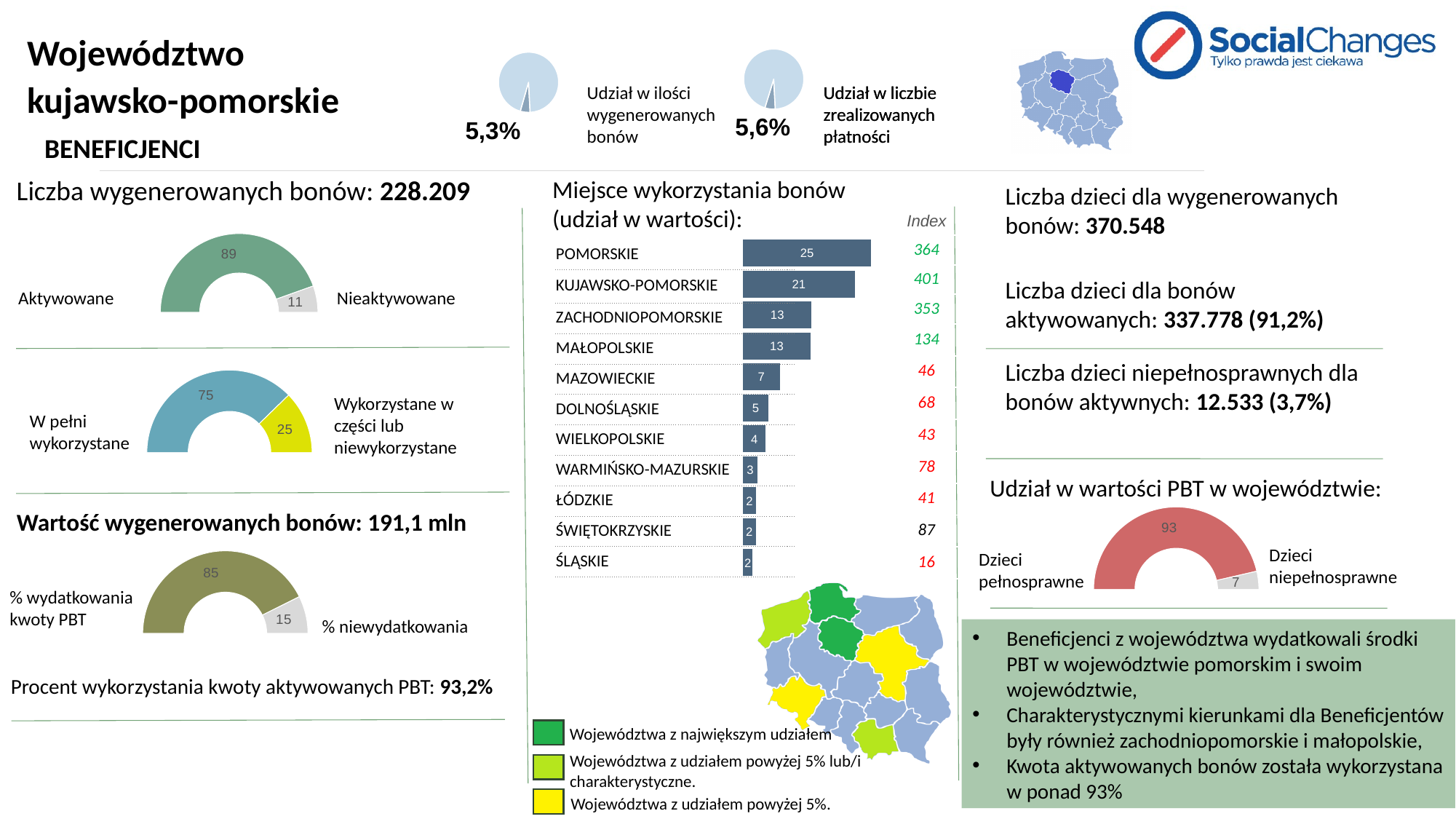
In the bar chart 'Miejsce wykorzystania bonów (udział w wartości)', what is the value for POMORSKIE? 25 In the bar chart 'Miejsce wykorzystania bonów (udział w wartości)', what is the value for KUJAWSKO-POMORSKIE? 21 How many categories are shown in the bar chart 'Miejsce wykorzystania bonów (udział w wartości)'? 11 In the top-left gauge chart under 'Liczba wygenerowanych bonów', what is the value for Aktywowane? 89 In the gauge chart under 'Wartość wygenerowanych bonów', what is the value for '% niewydatkowania'? 15 In the bar chart 'Miejsce wykorzystania bonów (udział w wartości)', which category has the highest value? POMORSKIE In the gauge chart under 'Udział w wartości PBT w województwie', what is the value for 'Dzieci niepełnosprawne'? 7 In the gauge chart with 'W pełni wykorzystane', what is the value for 'Wykorzystane w części lub niewykorzystane'? 25 In the bar chart 'Miejsce wykorzystania bonów (udział w wartości)', what is the Index value shown for KUJAWSKO-POMORSKIE? 401 In the bar chart 'Miejsce wykorzystania bonów (udział w wartości)', which is larger: the value for ZACHODNIOPOMORSKIE or the value for DOLNOŚLĄSKIE? ZACHODNIOPOMORSKIE What kind of chart is 'Miejsce wykorzystania bonów (udział w wartości)'? bar chart In the bar chart 'Miejsce wykorzystania bonów (udział w wartości)', what is the difference between the values for POMORSKIE and MAZOWIECKIE? 18